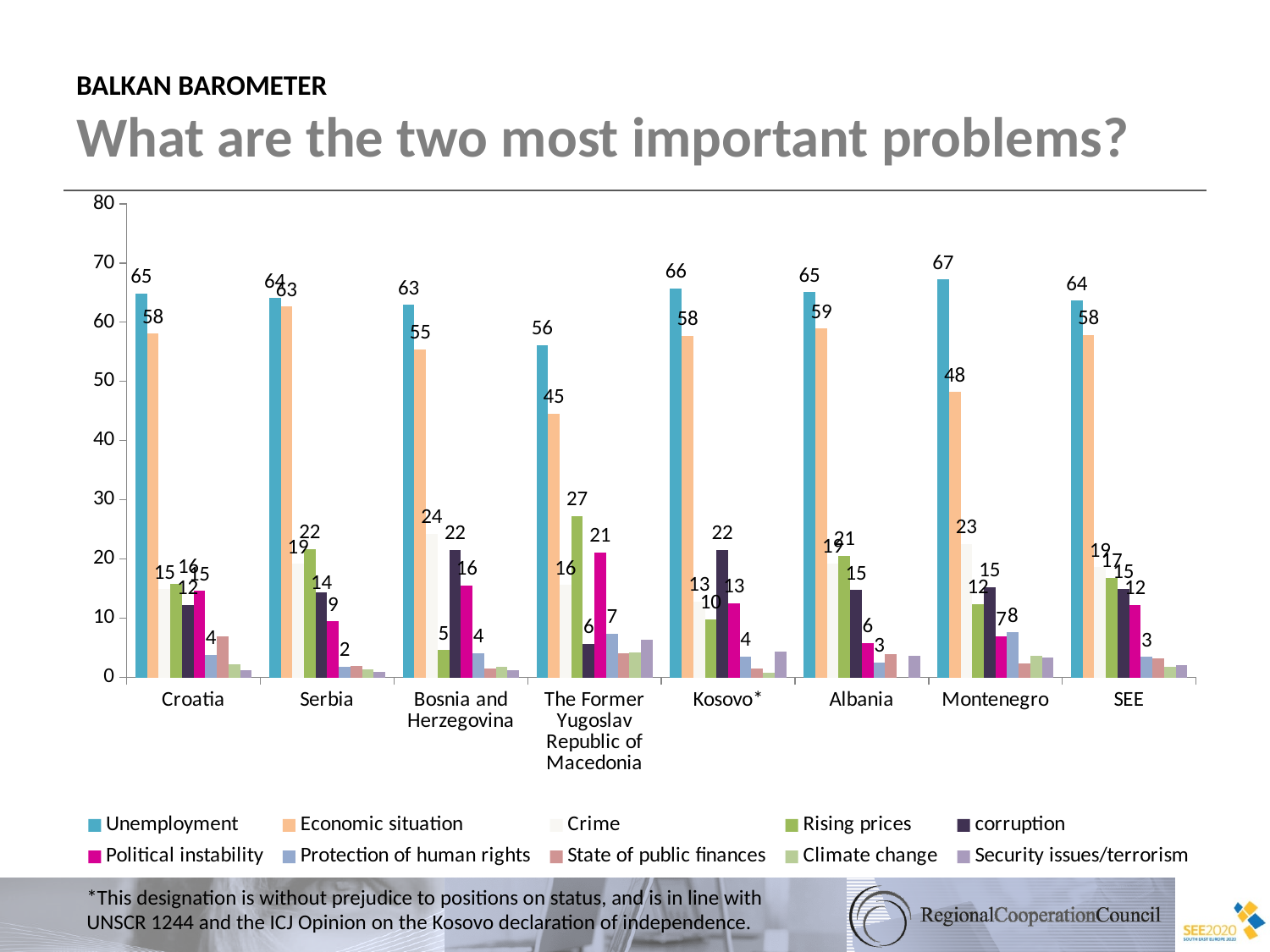
Is the Economic situation value for Serbia greater or less than 60? greater Which is larger for Kosovo*: corruption or Rising prices? corruption How many series does the legend list? 10 What is the difference between the Unemployment and Economic situation values for Montenegro? 19 Which country has the lowest Economic situation value? The Former Yugoslav Republic of Macedonia What is the Economic situation value for The Former Yugoslav Republic of Macedonia? 45 What kind of chart is shown on the slide? bar chart Which country has the highest Unemployment value? Montenegro How many countries/regions are shown on the x axis? 8 What is the Rising prices value for Bosnia and Herzegovina? 5 What is the Unemployment value for Montenegro? 67 What is the title of the slide? What are the two most important problems?